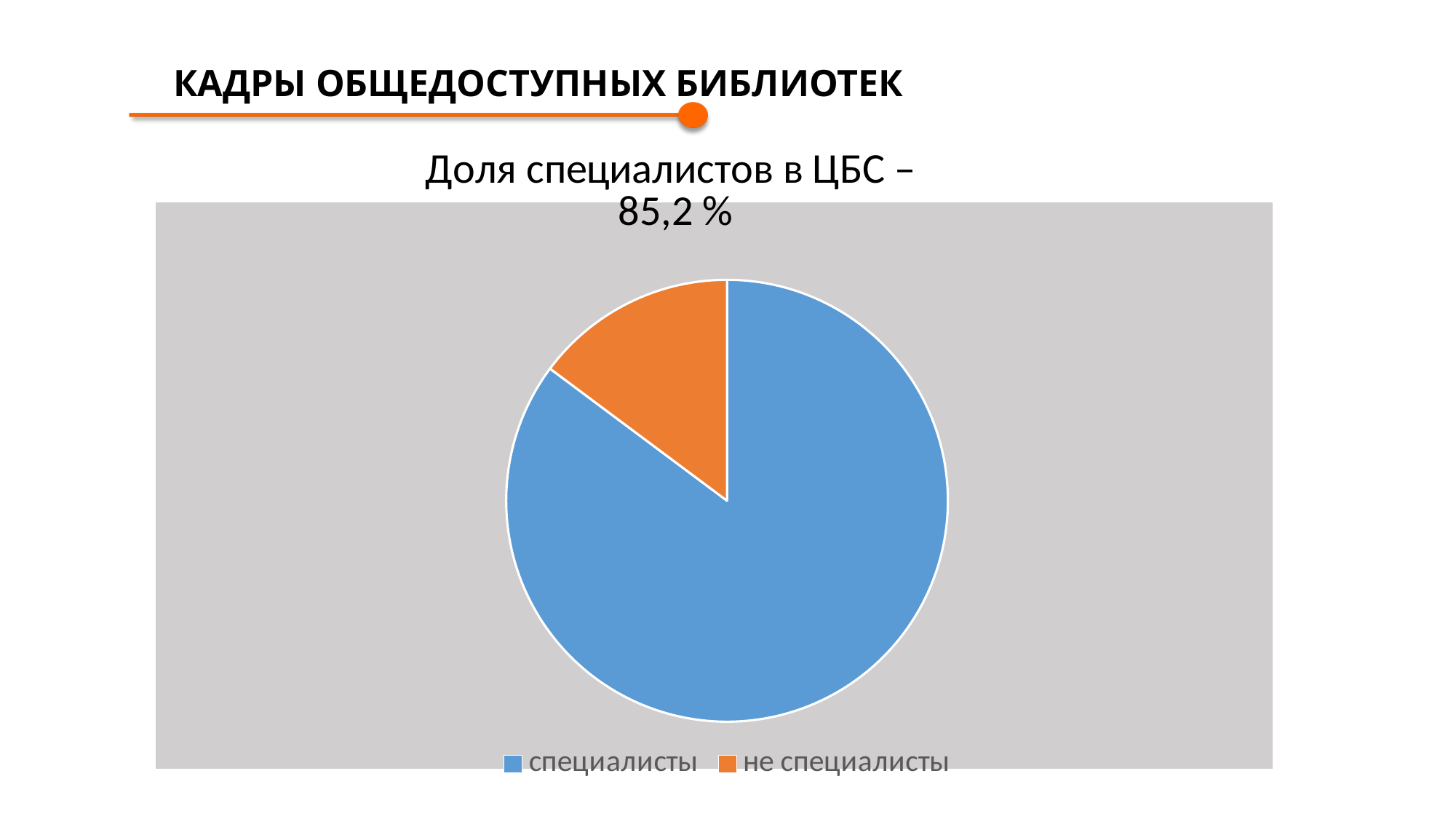
Which slice is larger: специалисты or не специалисты? специалисты According to the chart title, what is the share of специалисты in the ЦБС? 85,2 % How many slices does the pie chart have? 2 What kind of chart is shown on the slide? pie chart Which category has the largest slice in the pie chart? специалисты What colour is the slice for не специалисты? orange Is the share of не специалисты greater or less than 25%? less Which category has the smallest slice in the pie chart? не специалисты What is the title of the pie chart? Доля специалистов в ЦБС – 85,2 % Is the share of специалисты greater or less than 50%? greater How many entries does the legend of the pie chart list? 2